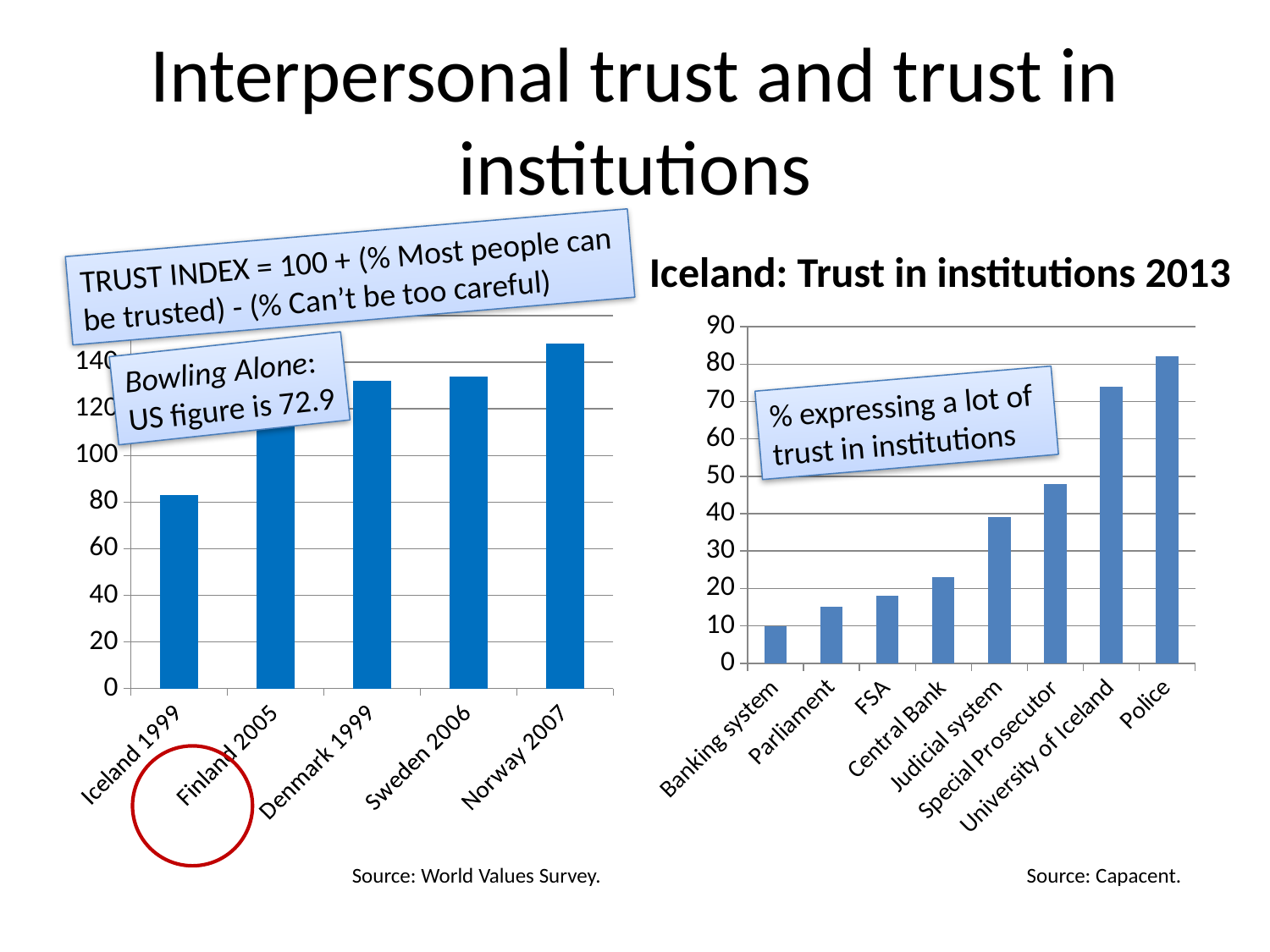
What kind of chart is the left chart on the slide? bar chart On the left chart, which category has the lowest value? Iceland 1999 On the chart titled 'Iceland: Trust in institutions 2013', which institution has the lowest value? Banking system On the left chart, is the value for Iceland 1999 greater or less than 100? less On the left chart, is the value for Norway 2007 greater or less than 140? greater How many categories are shown on the left chart? 5 On the chart titled 'Iceland: Trust in institutions 2013', do the values rise or fall from left to right along the x axis? rise On the left chart, which category has the highest value? Norway 2007 On the left chart, which is larger, the value for Finland 2005 or the value for Denmark 1999? Denmark 1999 On the chart titled 'Iceland: Trust in institutions 2013', which institution has the highest value? Police On the chart titled 'Iceland: Trust in institutions 2013', is the value for University of Iceland greater or less than 70? greater How many categories are shown on the chart titled 'Iceland: Trust in institutions 2013'? 8